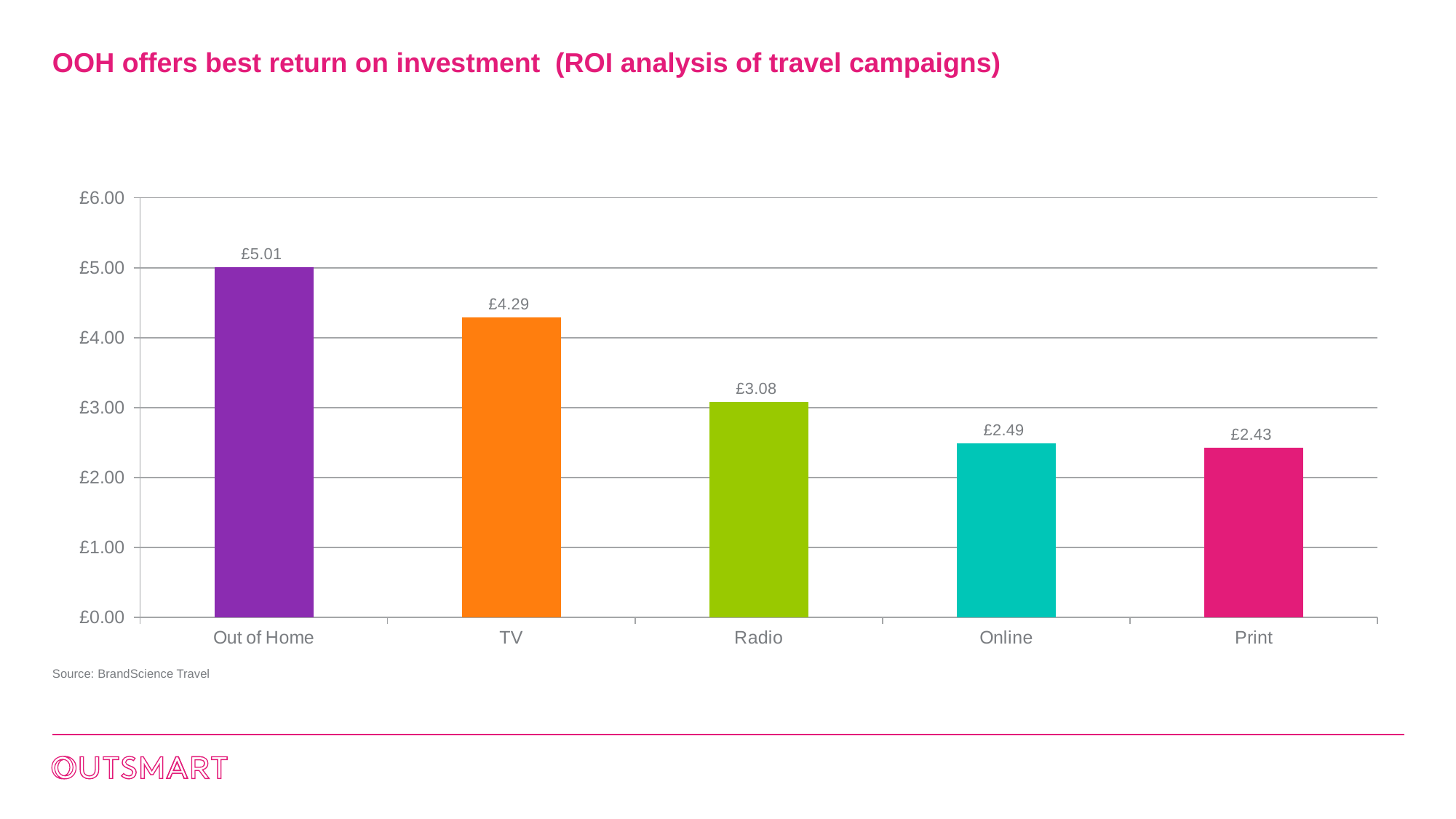
What is the ROI value for Radio? £3.08 What is the source cited below the chart? BrandScience Travel How many categories are shown in the chart? 5 What is the difference between the ROI for Out of Home and TV? £0.72 What kind of chart is shown on the slide? Bar chart Which category has the lowest ROI? Print What is the ROI value for Print? £2.43 Which has a larger ROI, TV or Radio? TV What is the difference between the ROI for Radio and Online? £0.59 Which category has the highest ROI? Out of Home Is the value for Online greater or less than £3.00? less What is the ROI value for Out of Home? £5.01